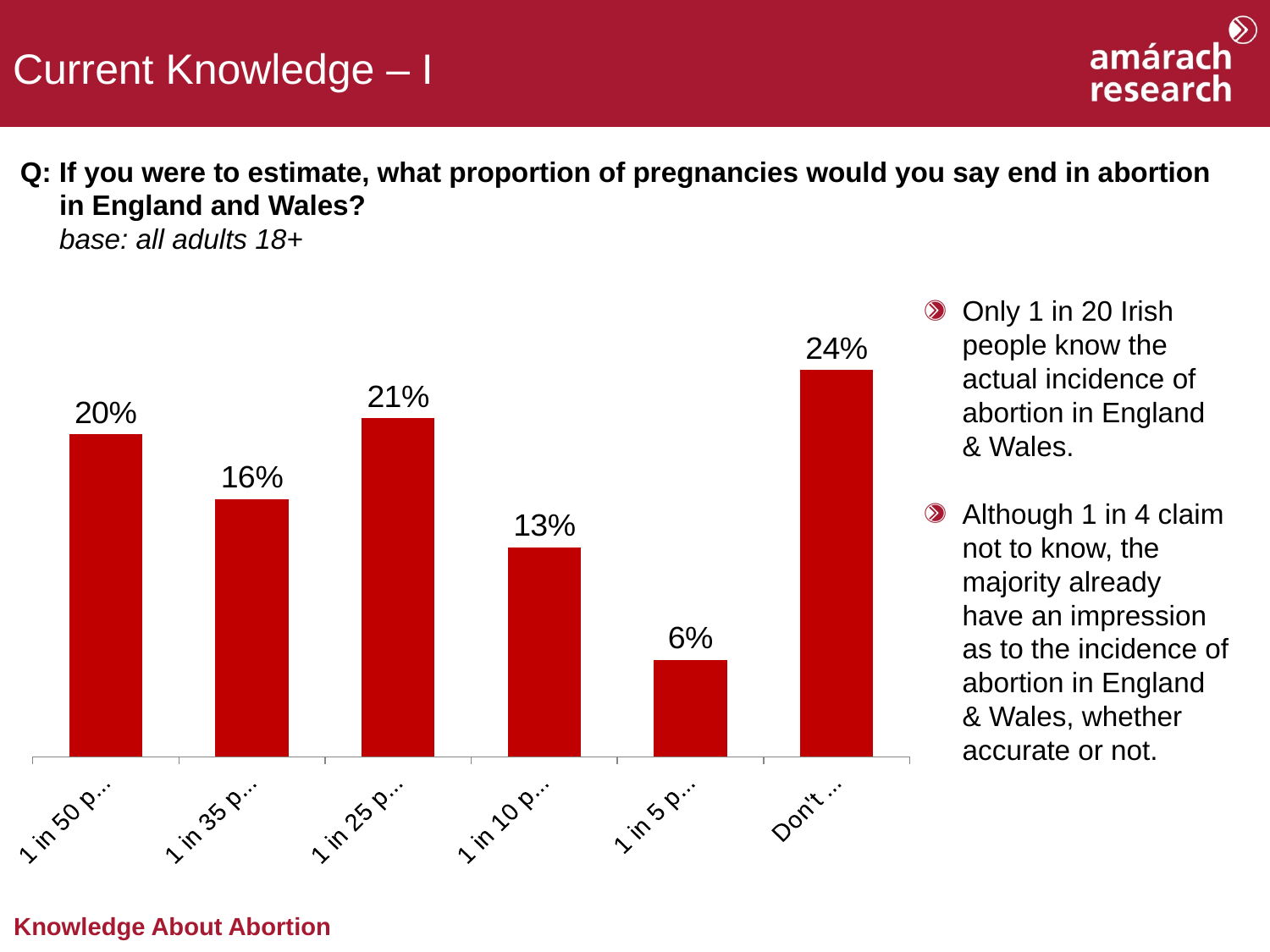
Which category has the highest value in the chart? Don't know Which category has the lowest value in the chart? 1 in 5 Which is larger, the value for '1 in 50' or the value for '1 in 35'? 1 in 50 What is the difference between the '1 in 25' value and the '1 in 10' value? 8% How many bars are shown in the chart? 6 What value is shown for the rightmost bar, labelled 'Don't ...'? 24% What percentage is shown for the '1 in 25' bar? 21% What type of chart is shown on the slide? Bar chart What value is shown for the '1 in 10' category? 13% What value is shown for the '1 in 35' category? 16% What percentage of respondents estimated '1 in 50' pregnancies end in abortion? 20% What percentage of respondents chose '1 in 5'? 6%